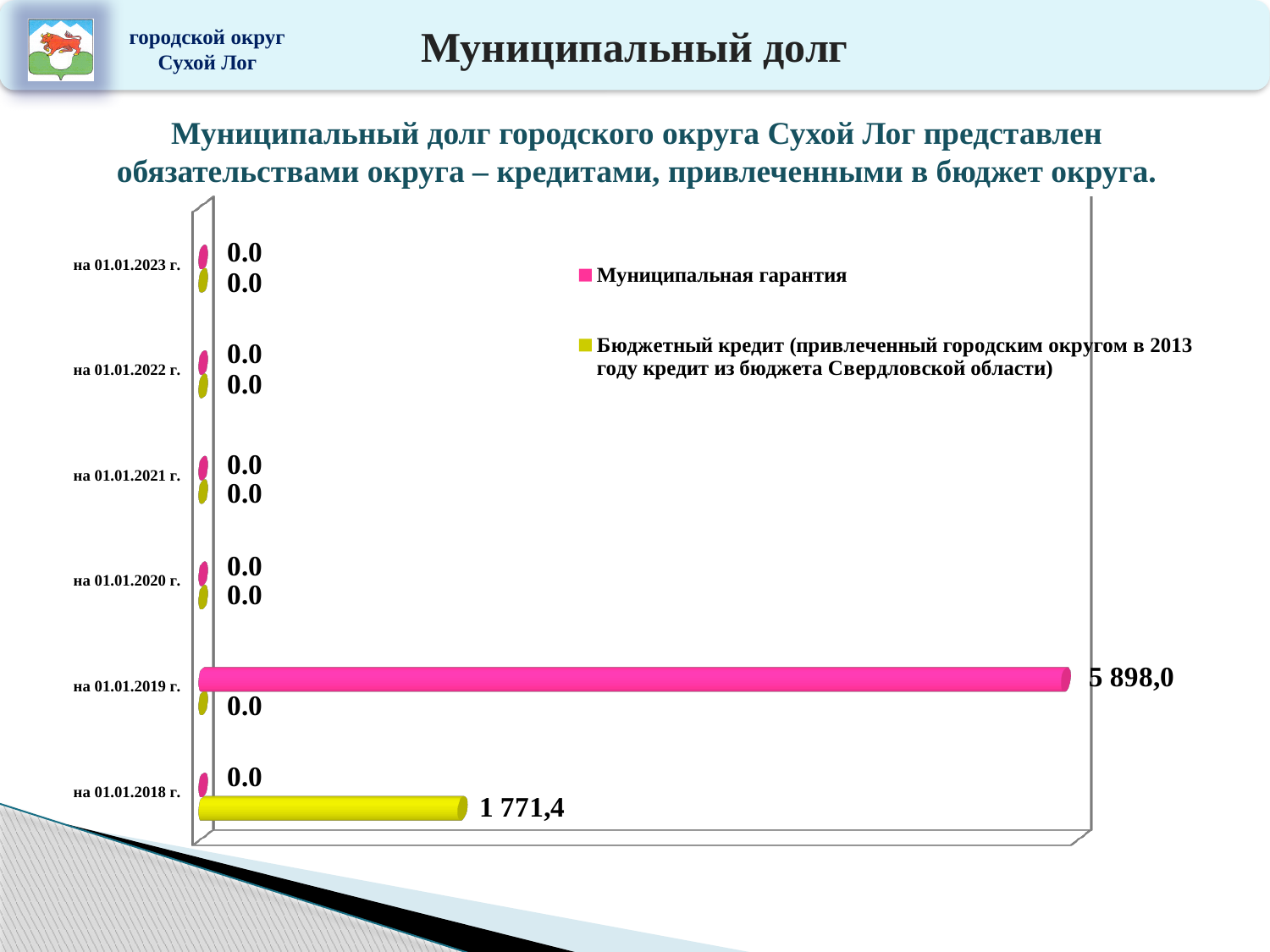
For which date is the Бюджетный кредит value highest? на 01.01.2018 г. What is the difference between Муниципальная гарантия на 01.01.2019 г. and Бюджетный кредит на 01.01.2018 г.? 4 126,6 Which is larger: Муниципальная гарантия на 01.01.2019 г. or Бюджетный кредит на 01.01.2018 г.? Муниципальная гарантия на 01.01.2019 г. What is the value of Бюджетный кредит на 01.01.2018 г.? 1 771,4 What kind of chart is shown on the slide? bar chart What is the value of Муниципальная гарантия на 01.01.2019 г.? 5 898,0 What is the value of Муниципальная гарантия на 01.01.2023 г.? 0.0 What is the value of Бюджетный кредит на 01.01.2019 г.? 0.0 For which date is the Муниципальная гарантия value highest? на 01.01.2019 г. What is the value of Муниципальная гарантия на 01.01.2018 г.? 0.0 How many date categories are shown on the chart? 6 How many series does the chart legend list? 2